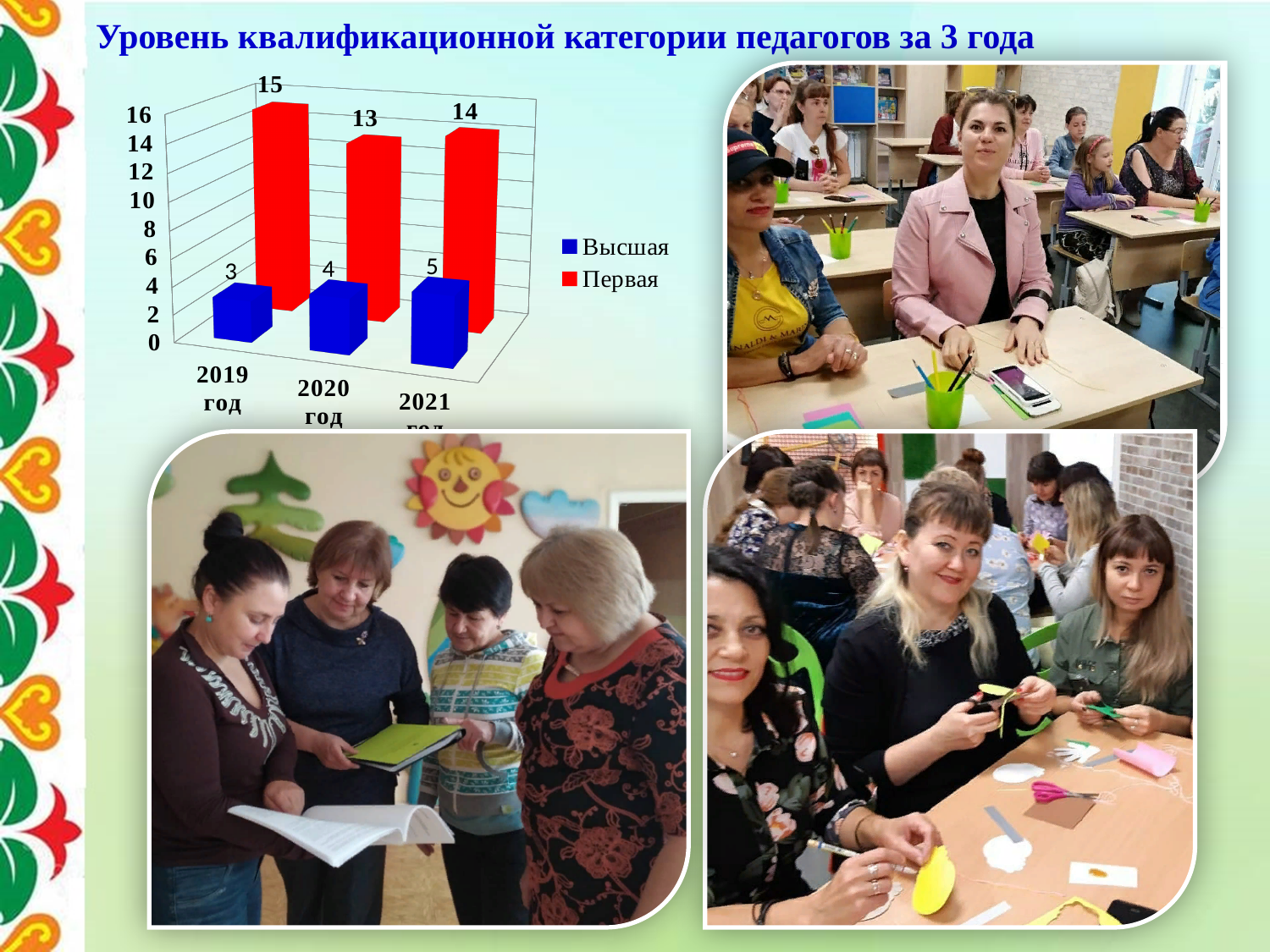
Which is larger in 2020 год, Высшая or Первая? Первая What kind of chart is shown on the slide? bar chart How many years are shown on the x axis? 3 What is the value for Первая in 2021 год? 14 What is the value for Высшая in 2019 год? 3 Do the values for Высшая rise or fall from 2019 год to 2021 год? rise In which year is the value for Высшая lowest? 2019 год In which year is the value for Первая highest? 2019 год How many series does the legend list? 2 What is the value for Первая in 2020 год? 13 What is the difference between Первая and Высшая in 2021 год? 9 What colour are the bars for Первая? red